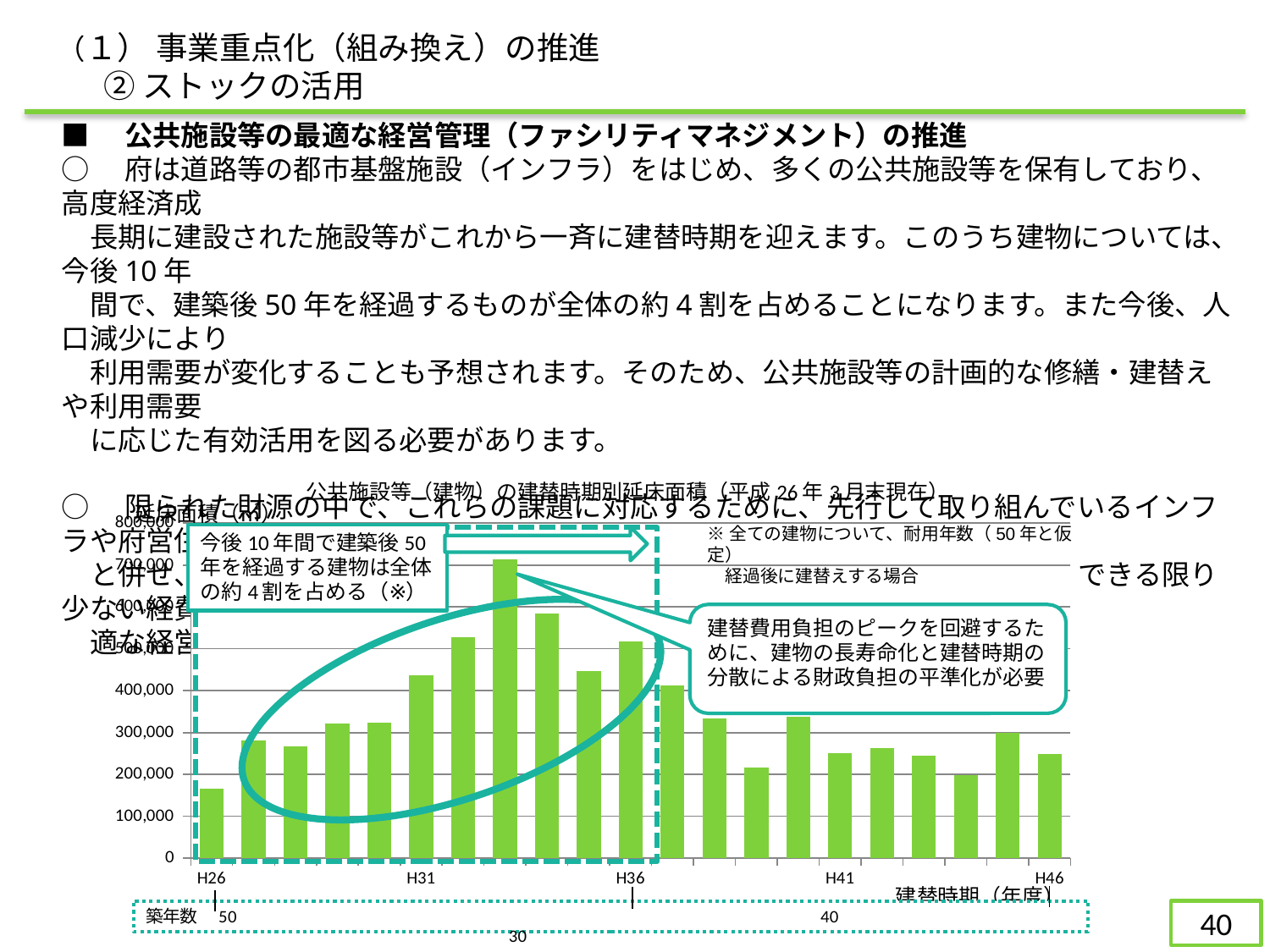
How many bars are plotted in the chart? 21 What is the label of the x axis of the chart? 建替時期（年度） What is the title of the chart? 公共施設等（建物）の建替時期別延床面積（平成26年3月末現在） Is the value for H33 greater or less than 600,000? greater Which is larger, the value for H31 or the value for H26? H31 Which year has the tallest bar in the chart? H33 Is the value for H26 greater or less than 200,000? less What kind of chart is shown on the slide? bar chart Do the values rise or fall from H26 to H33? rise Which year has the shortest bar in the chart? H26 Is the value for H41 greater or less than 300,000? less